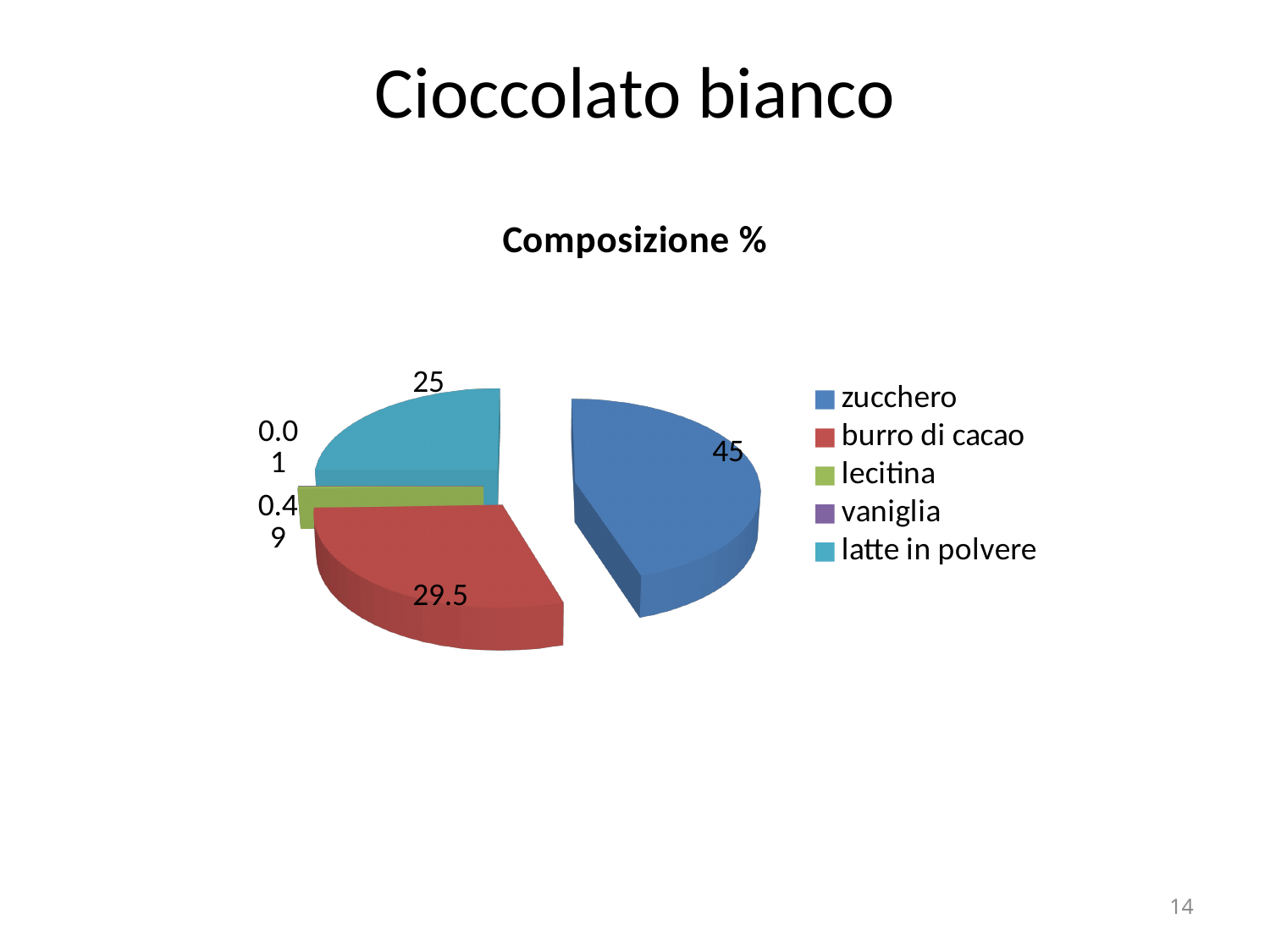
What is the difference between the values for burro di cacao and latte in polvere? 4.5 What is the value for latte in polvere in the Composizione % pie chart? 25 What is the difference between the values for zucchero and burro di cacao? 15.5 What is the difference between the values for zucchero and latte in polvere? 20 Which ingredient has the smallest slice in the Composizione % pie chart? vaniglia What is the title of the chart on the slide? Composizione % What kind of chart is shown on the slide? pie chart How many ingredients are listed in the legend of the pie chart? 5 What is the value for zucchero in the Composizione % pie chart? 45 What is the value for burro di cacao in the Composizione % pie chart? 29.5 Which is larger, the value for burro di cacao or the value for latte in polvere? burro di cacao Which ingredient has the largest slice in the Composizione % pie chart? zucchero